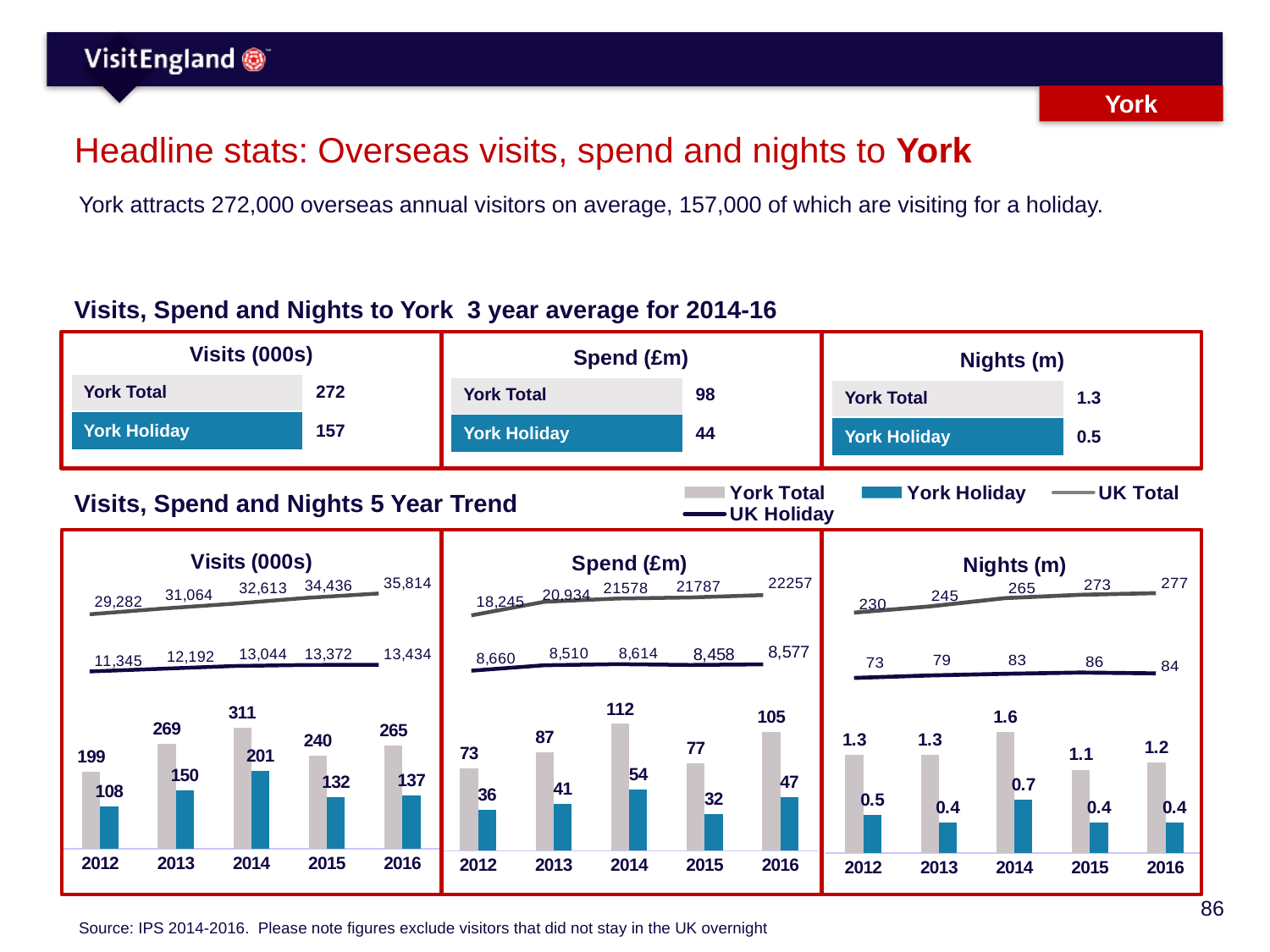
How many series does the legend for the 5 Year Trend charts list? 4 In the Spend (£m) 5 year trend chart, what is the York Holiday value for 2015? 32 In the Visits (000s) 5 year trend chart, what is the UK Total value for 2016? 35,814 In the Visits (000s) 5 year trend chart, does the UK Total line rise or fall from 2012 to 2016? rise In the Nights (m) 5 year trend chart, is the York Holiday value larger in 2012 or in 2013? 2012 In the Visits (000s) 5 year trend chart, what is the York Total value for 2014? 311 In the Nights (m) 5 year trend chart, what is the York Total value for 2014? 1.6 In the Spend (£m) 5 year trend chart, what is the difference between York Total and York Holiday in 2014? 58 In the Spend (£m) 5 year trend chart, which year has the lowest York Total value? 2012 How many years are shown on the x axis of the Visits (000s) 5 year trend chart? 5 In the Visits (000s) 5 year trend chart, which year has the highest York Total value? 2014 In the Nights (m) 5 year trend chart, what is the UK Holiday value for 2016? 84